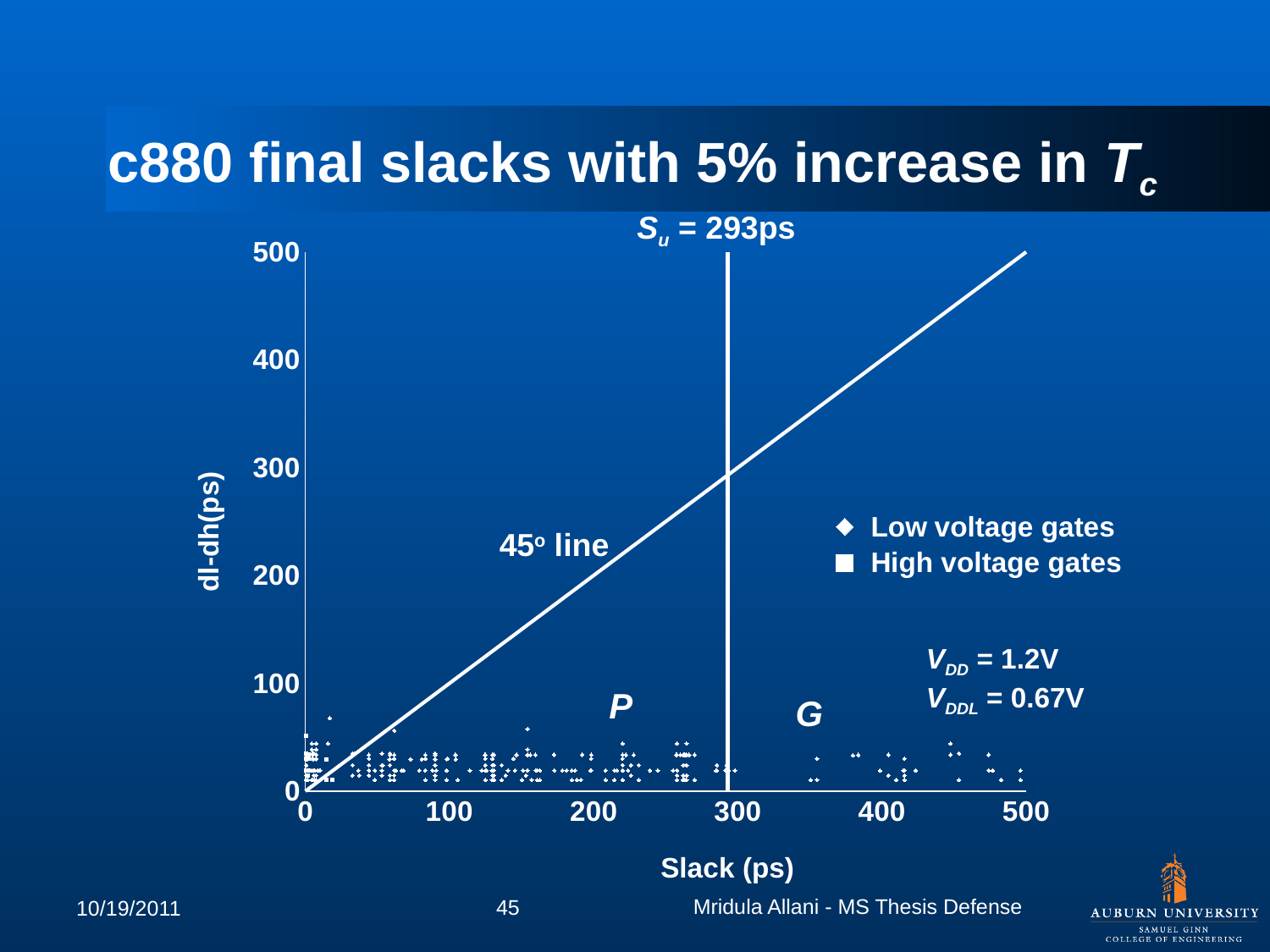
Are the dl-dh values of the plotted gates greater or less than 100? less What kind of chart is shown on the slide? scatter plot What are the two series named in the legend? Low voltage gates and High voltage gates What is the label of the x axis? Slack (ps) How many series does the legend list? 2 What value of V_DD is stated on the chart? 1.2V What value of V_DDL is stated on the chart? 0.67V What value of S_u is marked by the vertical line on the chart? 293ps